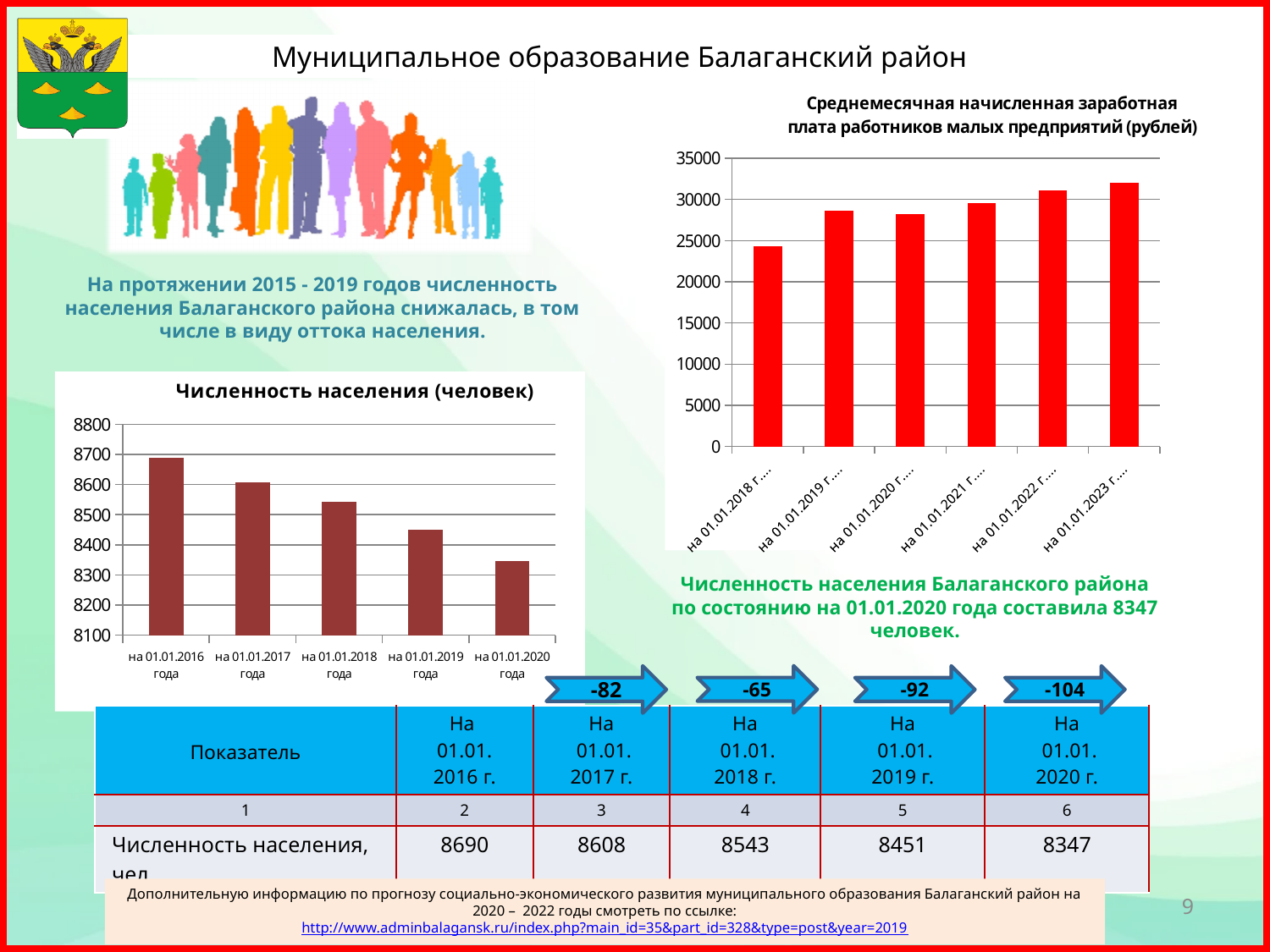
On the 'Численность населения (человек)' chart, do the values rise or fall from left to right? fall On the 'Численность населения (человек)' chart, how many dates are plotted? 5 On the 'Среднемесячная начисленная заработная плата' chart, is the value for на 01.01.2018 г. greater or less than 25000? less On the 'Численность населения (человек)' chart, which date has the lowest population? на 01.01.2020 года On the 'Численность населения (человек)' chart, what is the difference between the population on 01.01.2016 and on 01.01.2020? 343 On the 'Численность населения (человек)' chart, what is the population value for на 01.01.2016 года? 8690 On the 'Численность населения (человек)' chart, what is the population value for на 01.01.2020 года? 8347 On the 'Среднемесячная начисленная заработная плата' chart, how many bars are plotted? 6 On the 'Среднемесячная начисленная заработная плата' chart, which date has the highest value? на 01.01.2023 г. On the 'Численность населения (человек)' chart, which date has the highest population? на 01.01.2016 года On the 'Среднемесячная начисленная заработная плата' chart, is the value for на 01.01.2023 г. greater or less than 30000? greater What kind of chart is the 'Среднемесячная начисленная заработная плата работников малых предприятий (рублей)' chart? bar chart